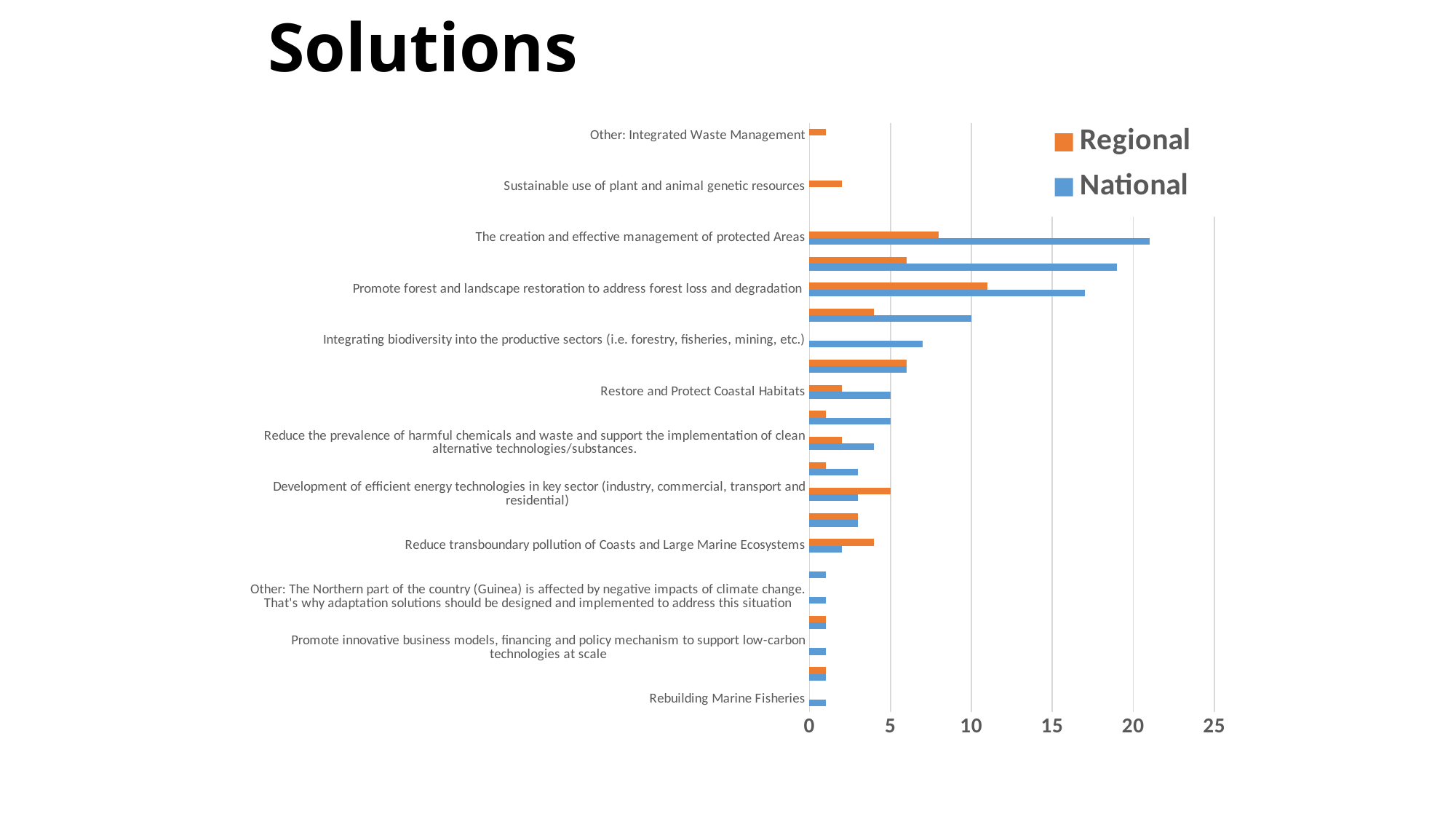
What are the two series named in the legend? Regional and National What type of chart is shown on the slide? bar chart Is the Regional value for 'Promote forest and landscape restoration to address forest loss and degradation' greater or less than 15? less Is the National value for 'Promote forest and landscape restoration to address forest loss and degradation' greater or less than 15? greater Which labelled category has the highest National value? The creation and effective management of protected Areas Which colour represents the Regional series? orange For 'Reduce transboundary pollution of Coasts and Large Marine Ecosystems', which series has the larger value, Regional or National? Regional For 'The creation and effective management of protected Areas', which series has the larger value, Regional or National? National How many series does the legend list? 2 What is the National value for 'Restore and Protect Coastal Habitats'? 5 Is the National value for 'The creation and effective management of protected Areas' greater or less than 20? greater